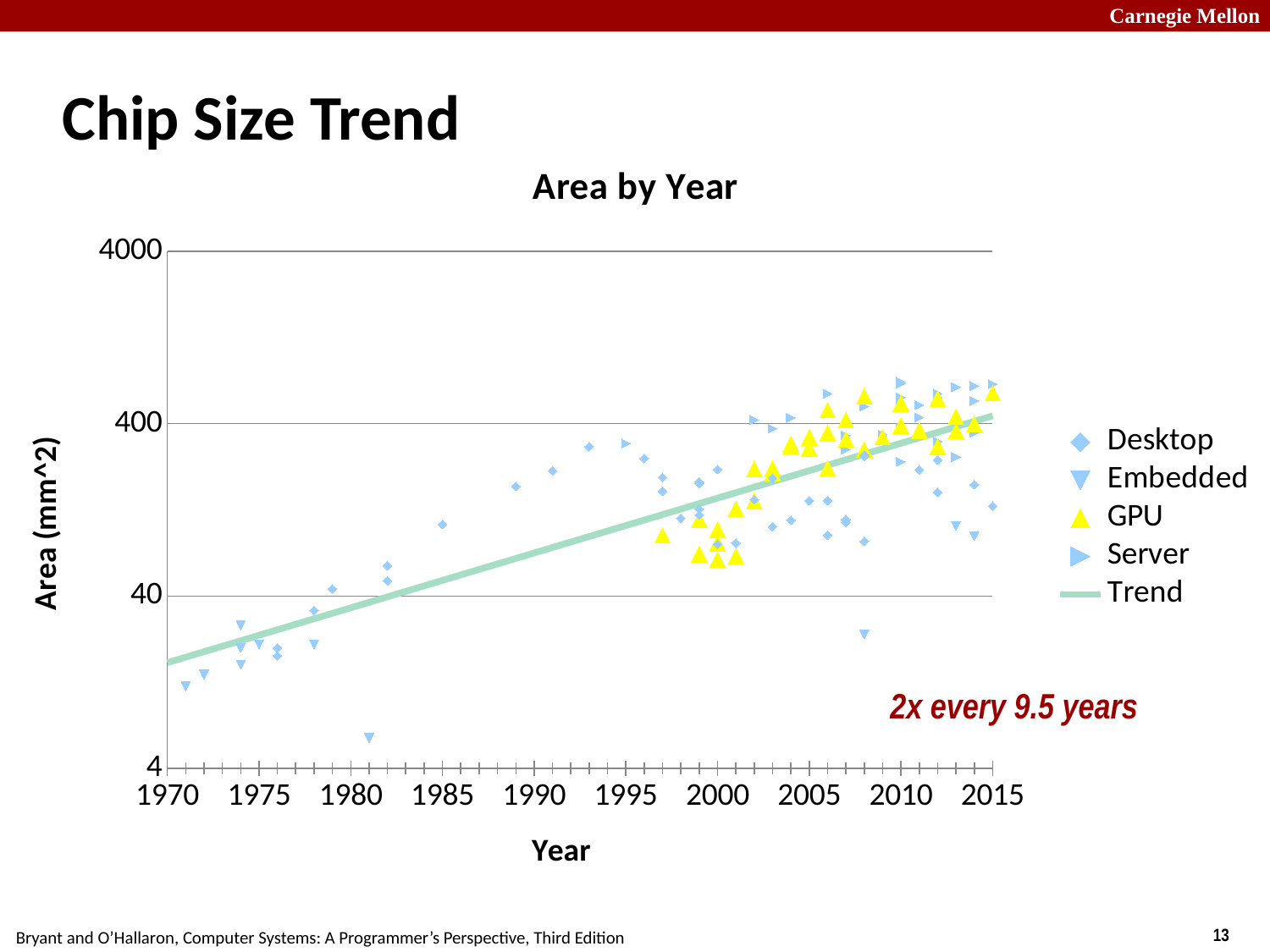
Is the Desktop point near 1985 greater or less than 40? greater Do the values along the Trend line rise or fall as the year increases? rise How many series does the legend list? 5 What growth rate is annotated on the chart? 2x every 9.5 years Is the Trend line value at 2015 greater or less than 40? greater Are the GPU points around the year 2000 greater or less than 400? less What kind of chart is shown on the slide? scatter chart What is the title of the chart? Area by Year